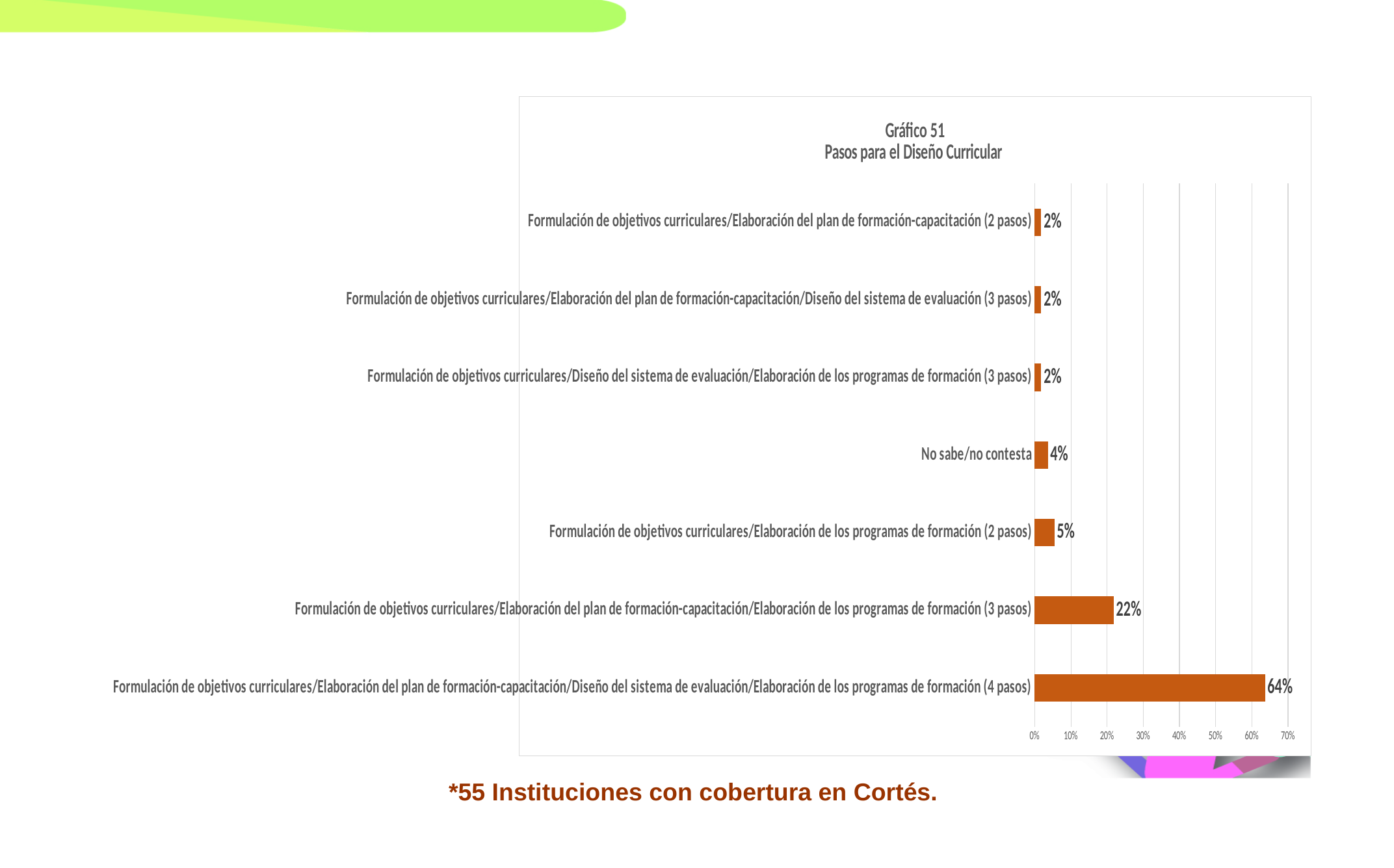
What is the value for 'Formulación de objetivos curriculares/Elaboración de los programas de formación (2 pasos)'? 5% What type of chart is shown on the slide? Bar chart How many categories are plotted in the chart? 7 What is the difference between the value for the 4 pasos category (64%) and the 3 pasos category with 22%? 42% What is the title of the chart? Gráfico 51 Pasos para el Diseño Curricular What is the value for 'Formulación de objetivos curriculares/Elaboración del plan de formación-capacitación (2 pasos)'? 2% What is the value for 'No sabe/no contesta'? 4% What is the value for 'Formulación de objetivos curriculares/Elaboración del plan de formación-capacitación/Elaboración de los programas de formación (3 pasos)'? 22% Which category has the highest value? Formulación de objetivos curriculares/Elaboración del plan de formación-capacitación/Diseño del sistema de evaluación/Elaboración de los programas de formación (4 pasos) What is the value for the 4 pasos category (Formulación de objetivos curriculares/Elaboración del plan de formación-capacitación/Diseño del sistema de evaluación/Elaboración de los programas de formación)? 64% Is the value for the 4 pasos category greater or less than 60%? greater Which is larger: the value for 'No sabe/no contesta' or the value for 'Formulación de objetivos curriculares/Elaboración de los programas de formación (2 pasos)'? Formulación de objetivos curriculares/Elaboración de los programas de formación (2 pasos)